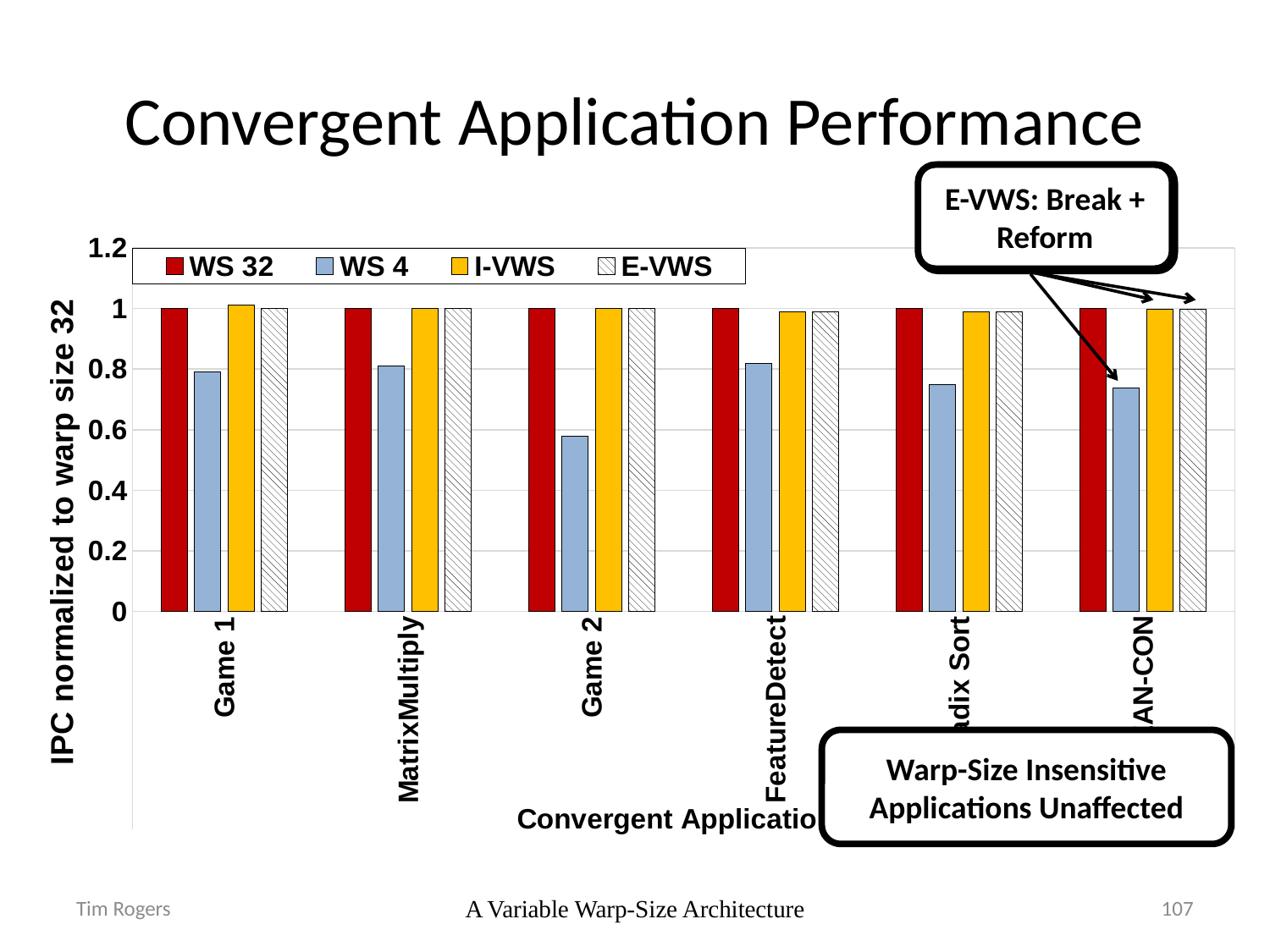
How many application categories are plotted along the x axis? 6 Which is larger, the WS 4 value for Game 1 or the WS 4 value for Game 2? Game 1 Is the WS 4 value for Game 1 greater or less than 1? less Is the WS 4 value for MatrixMultiply greater or less than 0.6? greater Among the WS 4 bars, which application has the lowest value? Game 2 What is the WS 32 value for Game 1? 1 What kind of chart is shown on the slide? bar chart How many series does the legend list? 4 Is the WS 4 value for Game 2 greater or less than 0.8? less What is the WS 32 value for MatrixMultiply? 1 Which series is shown in red in the legend? WS 32 What is the title of the chart's y axis? IPC normalized to warp size 32